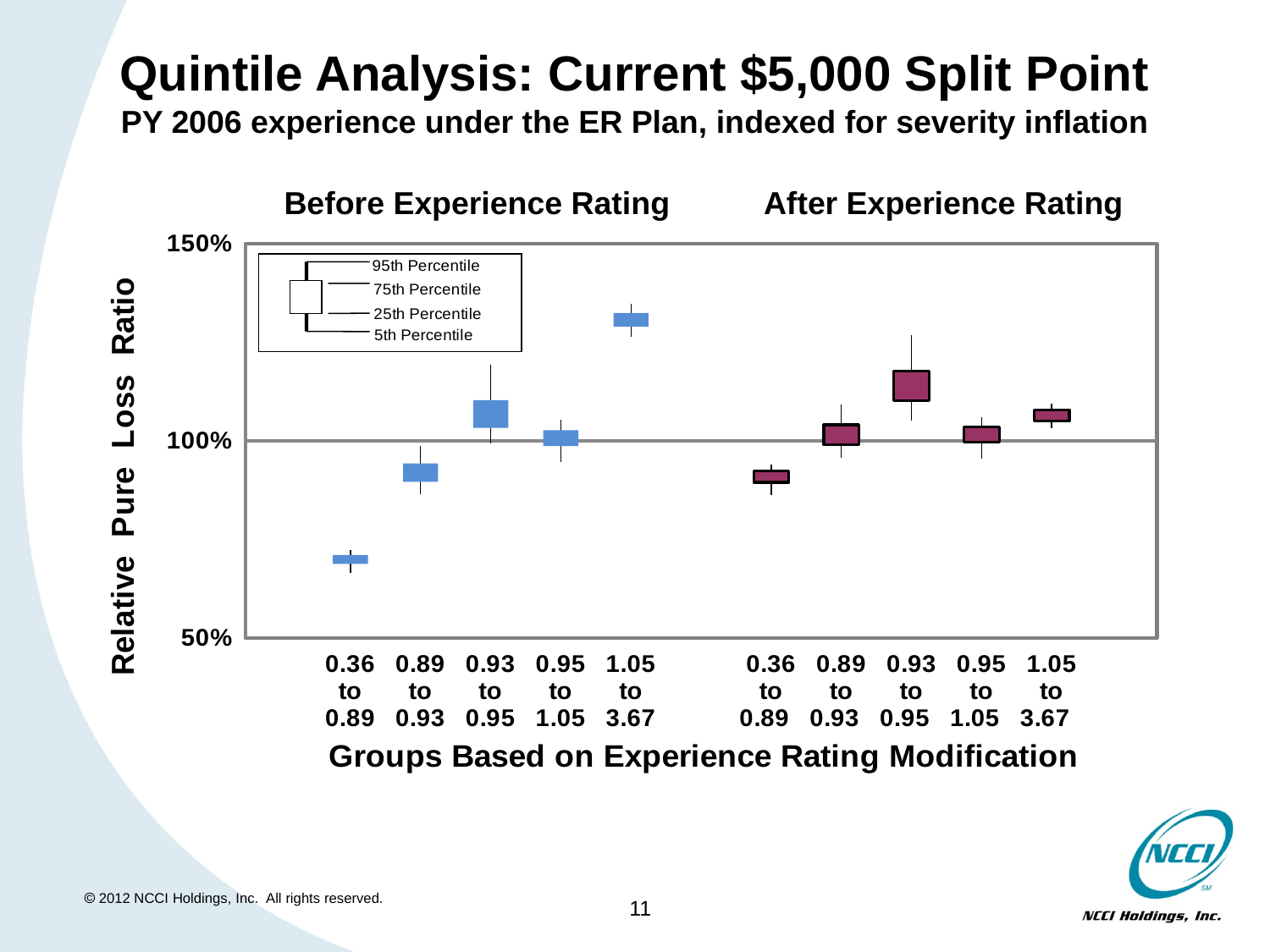
What is the label of the x axis of the chart? Groups Based on Experience Rating Modification In the Before Experience Rating panel, which group has the highest relative pure loss ratio? 1.05 to 3.67 How many experience rating modification groups are shown in the Before Experience Rating panel? 5 For the 1.05 to 3.67 group, is the relative pure loss ratio larger before or after experience rating? before In the After Experience Rating panel, is the relative pure loss ratio for the 0.36 to 0.89 group greater or less than 100%? less In the After Experience Rating panel, which group has the highest relative pure loss ratio? 0.93 to 0.95 In the Before Experience Rating panel, which group has the lowest relative pure loss ratio? 0.36 to 0.89 What kind of chart is shown on the slide? box plot In the Before Experience Rating panel, is the relative pure loss ratio for the 0.36 to 0.89 group greater or less than 100%? less Do the relative pure loss ratios in the Before Experience Rating panel rise or fall from the 0.36 to 0.89 group to the 1.05 to 3.67 group? rise In the After Experience Rating panel, is the relative pure loss ratio for the 0.93 to 0.95 group greater or less than 100%? greater